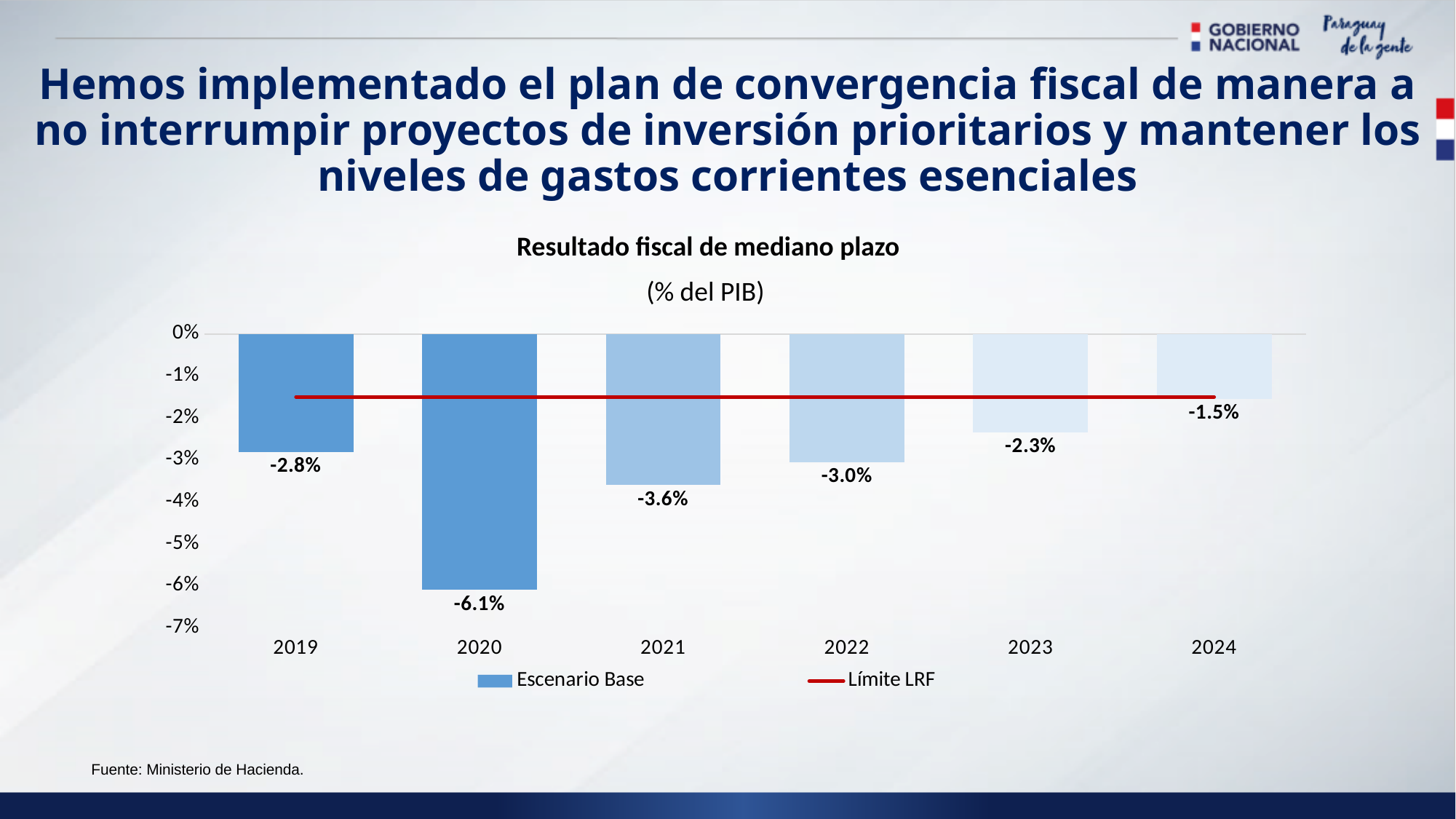
Do the Escenario Base values rise or fall from 2020 to 2024 in the Resultado fiscal de mediano plazo chart? Rise What kind of chart is the Resultado fiscal de mediano plazo chart? Bar chart with a line What is the value for 2022 in the Resultado fiscal de mediano plazo chart? -3.0% How many series does the legend of the Resultado fiscal de mediano plazo chart list? 2 What is the value for 2020 in the Resultado fiscal de mediano plazo chart? -6.1% What is the difference between the values for 2020 and 2019 in the Resultado fiscal de mediano plazo chart? 3.3 percentage points Which year has the highest value in the Resultado fiscal de mediano plazo chart? 2024 How many years are shown on the x axis of the Resultado fiscal de mediano plazo chart? 6 Is the Límite LRF line in the Resultado fiscal de mediano plazo chart greater or less than -1%? less Which is larger in the Resultado fiscal de mediano plazo chart, the value for 2021 or the value for 2023? 2023 Which year has the lowest (most negative) value in the Resultado fiscal de mediano plazo chart? 2020 What is the value for 2024 in the Resultado fiscal de mediano plazo chart? -1.5%